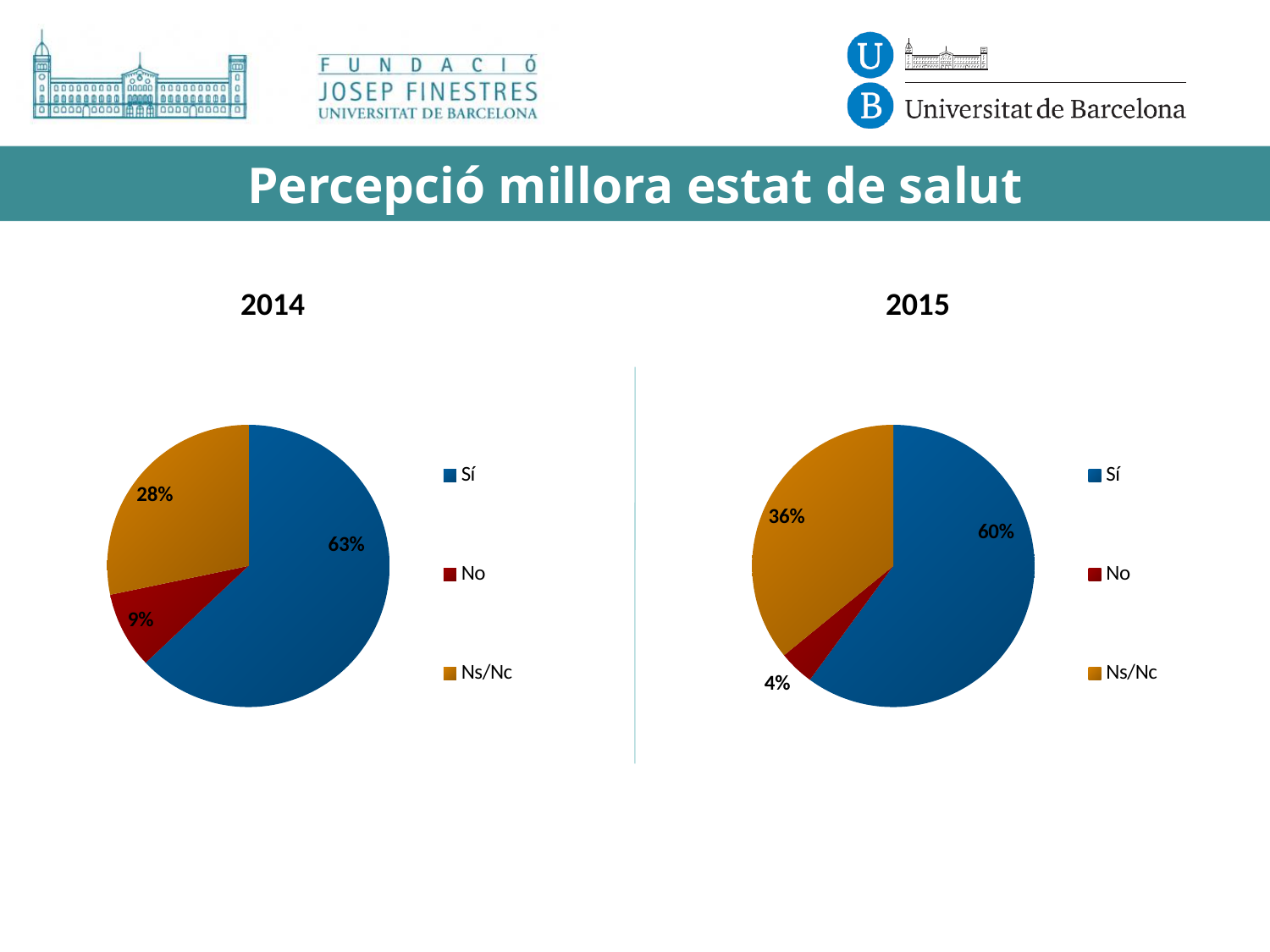
In the 2015 chart, what is the difference between the Sí and Ns/Nc shares? 24% In the 2014 chart, what percentage is shown for No? 9% What is the difference between the Sí share in 2014 and the Sí share in 2015? 3% In the 2015 chart, what percentage is shown for Ns/Nc? 36% In the 2014 chart, which category has the smallest slice? No In the 2014 chart, what percentage is shown for Sí? 63% In the 2015 chart, which category has the largest slice? Sí Is the Ns/Nc share larger in the 2014 chart or the 2015 chart? 2015 What colour represents the No category in both charts? Dark red What type of chart is used for the 2015 data? Pie chart In the 2015 chart, what percentage is shown for No? 4% How many categories does the 2014 pie chart show? 3